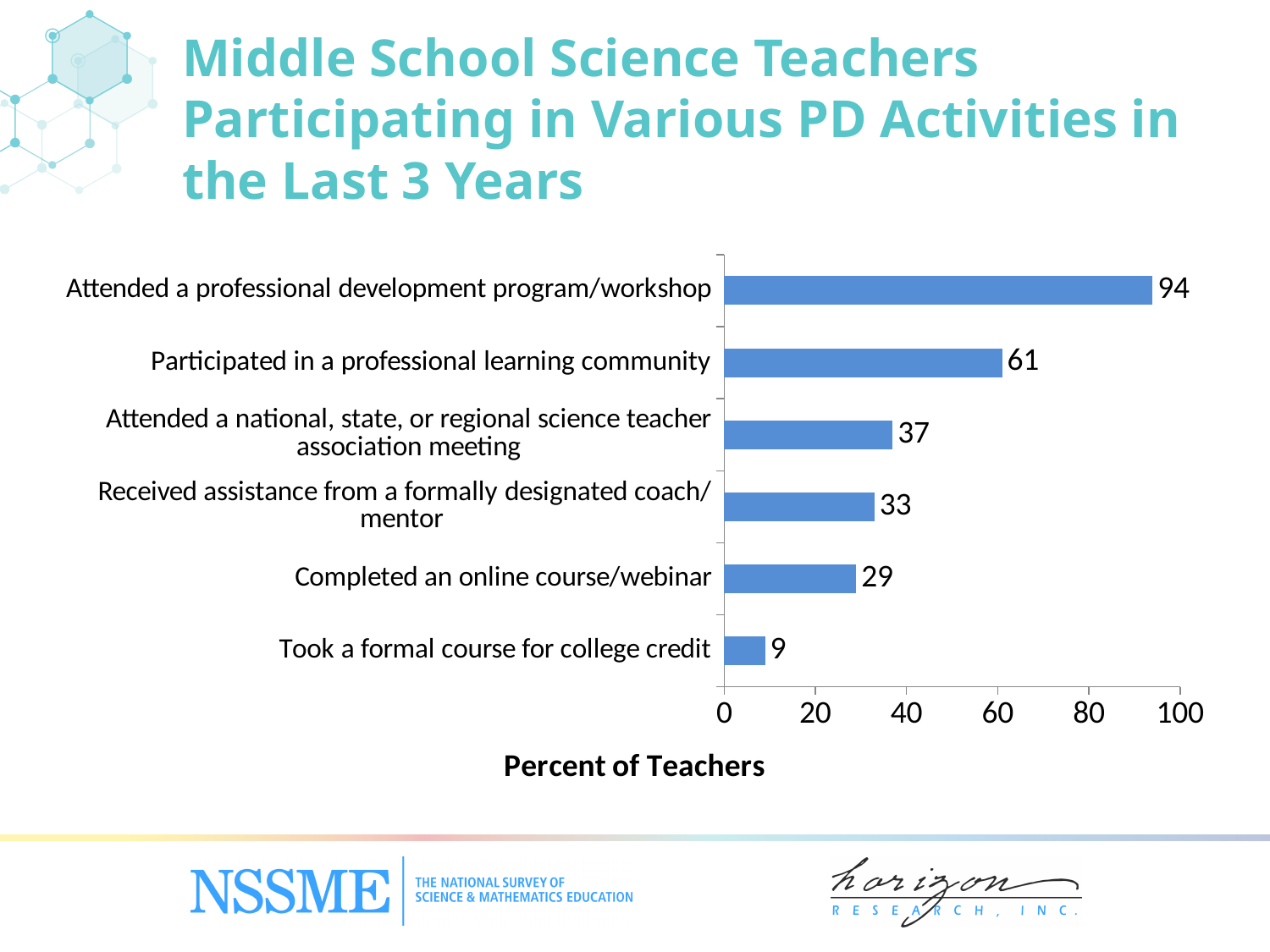
Which PD activity has the lowest percent of teachers? Took a formal course for college credit How many PD activities are shown in the chart? 6 Which is larger: the value for 'Completed an online course/webinar' or 'Received assistance from a formally designated coach/mentor'? Received assistance from a formally designated coach/mentor Which PD activity has the highest percent of teachers? Attended a professional development program/workshop What is the label of the horizontal axis? Percent of Teachers What percent of teachers attended a professional development program/workshop? 94 What is the difference between the values for 'Attended a national, state, or regional science teacher association meeting' and 'Received assistance from a formally designated coach/mentor'? 4 What is the value for 'Participated in a professional learning community'? 61 What is the value for 'Completed an online course/webinar'? 29 What is the difference between the values for 'Attended a professional development program/workshop' and 'Participated in a professional learning community'? 33 What kind of chart is shown on the slide? Bar chart What percent of teachers took a formal course for college credit? 9